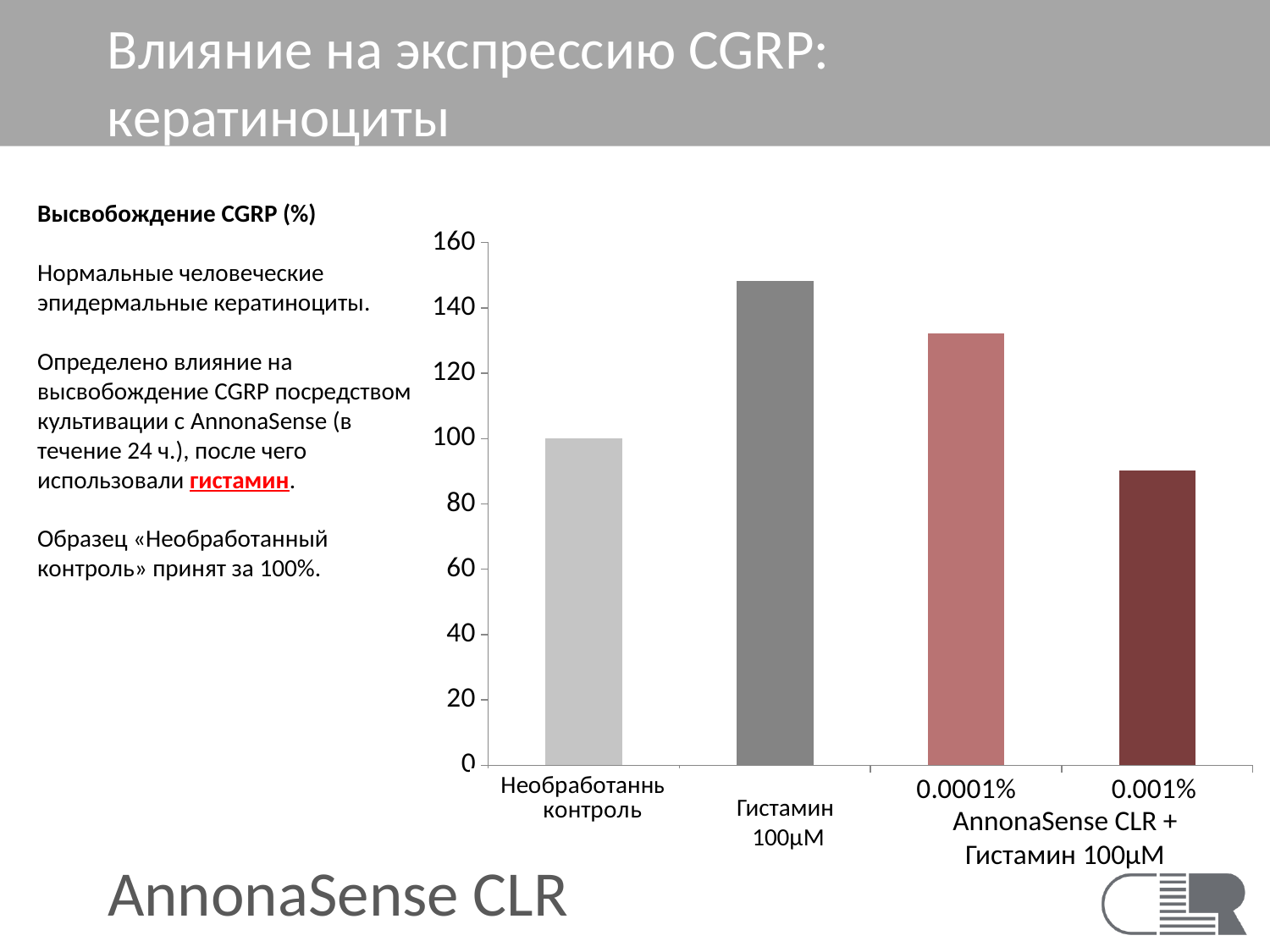
Which is larger: the value for Гистамин 100µM or the value for 0.0001% AnnonaSense CLR + Гистамин 100µM? Гистамин 100µM Is the value for 0.001% AnnonaSense CLR + Гистамин 100µM greater or less than 100? less Do the values rise or fall from Гистамин 100µM to 0.001% AnnonaSense CLR + Гистамин 100µM? fall Is the value for 0.0001% AnnonaSense CLR + Гистамин 100µM greater or less than 120? greater What is the value for Необработанный контроль? 100 Is the value for Гистамин 100µM greater or less than 140? greater Which is larger: the value for Необработанный контроль or the value for 0.001% AnnonaSense CLR + Гистамин 100µM? Необработанный контроль What kind of chart is shown on the slide? bar chart Which category has the lowest bar in the chart? 0.001% AnnonaSense CLR + Гистамин 100µM How many bars are plotted in the chart? 4 Which category has the highest bar in the chart? Гистамин 100µM